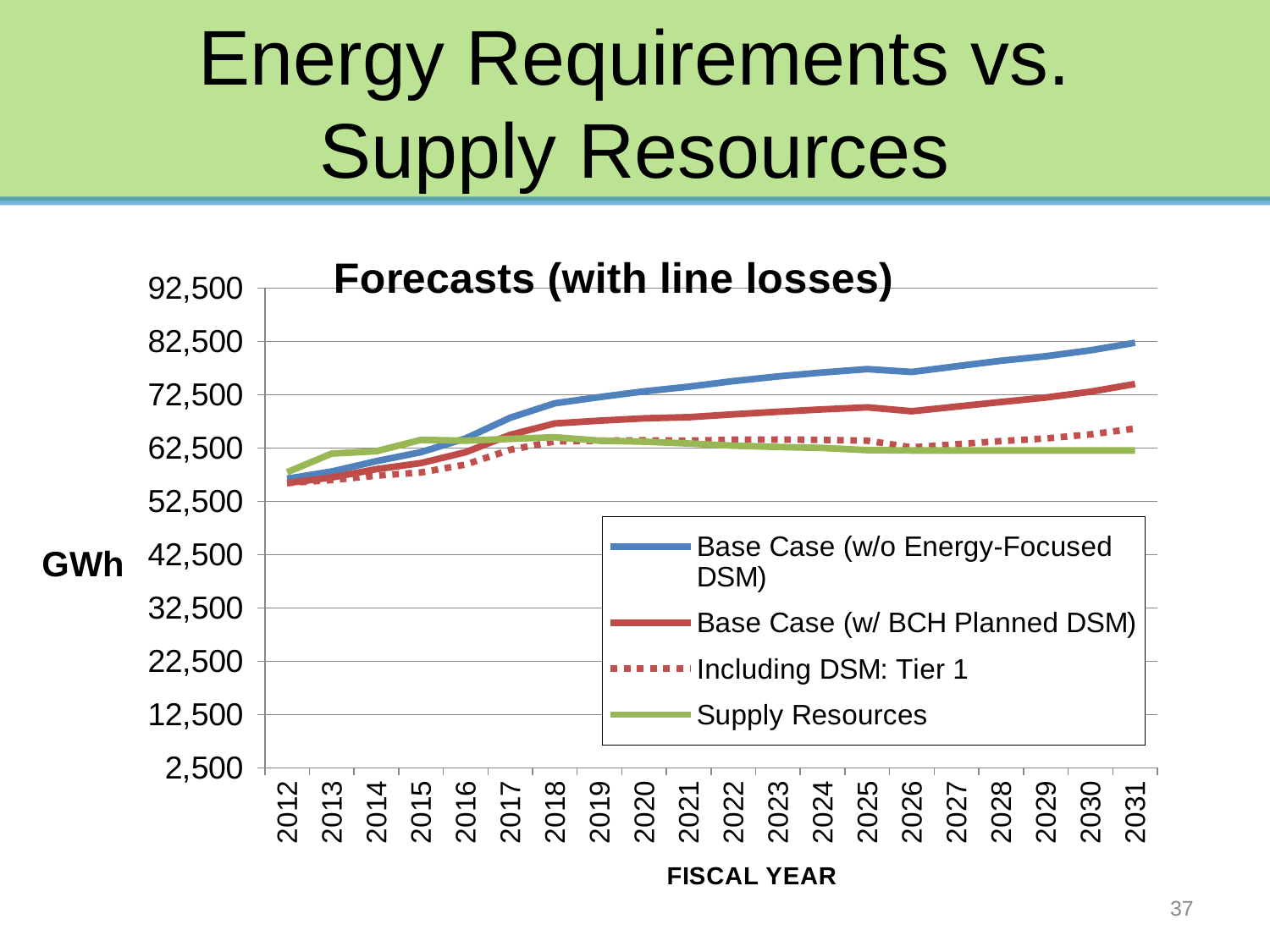
What is the title of the chart? Forecasts (with line losses) What unit is shown on the y axis label? GWh How many series does the legend list? 4 Which series has the lowest value in 2031? Supply Resources Is the value for Supply Resources in 2012 greater or less than 62,500? less Which series has the highest value in 2031? Base Case (w/o Energy-Focused DSM) Is the value for Base Case (w/o Energy-Focused DSM) in 2025 greater or less than 72,500? greater Does the Base Case (w/o Energy-Focused DSM) line rise or fall from 2012 to 2031? rise What kind of chart is shown on the slide? line chart Is the value for Including DSM: Tier 1 in 2031 greater or less than 72,500? less How many fiscal years are plotted along the x axis? 20 In 2031, which is larger: Base Case (w/ BCH Planned DSM) or Supply Resources? Base Case (w/ BCH Planned DSM)